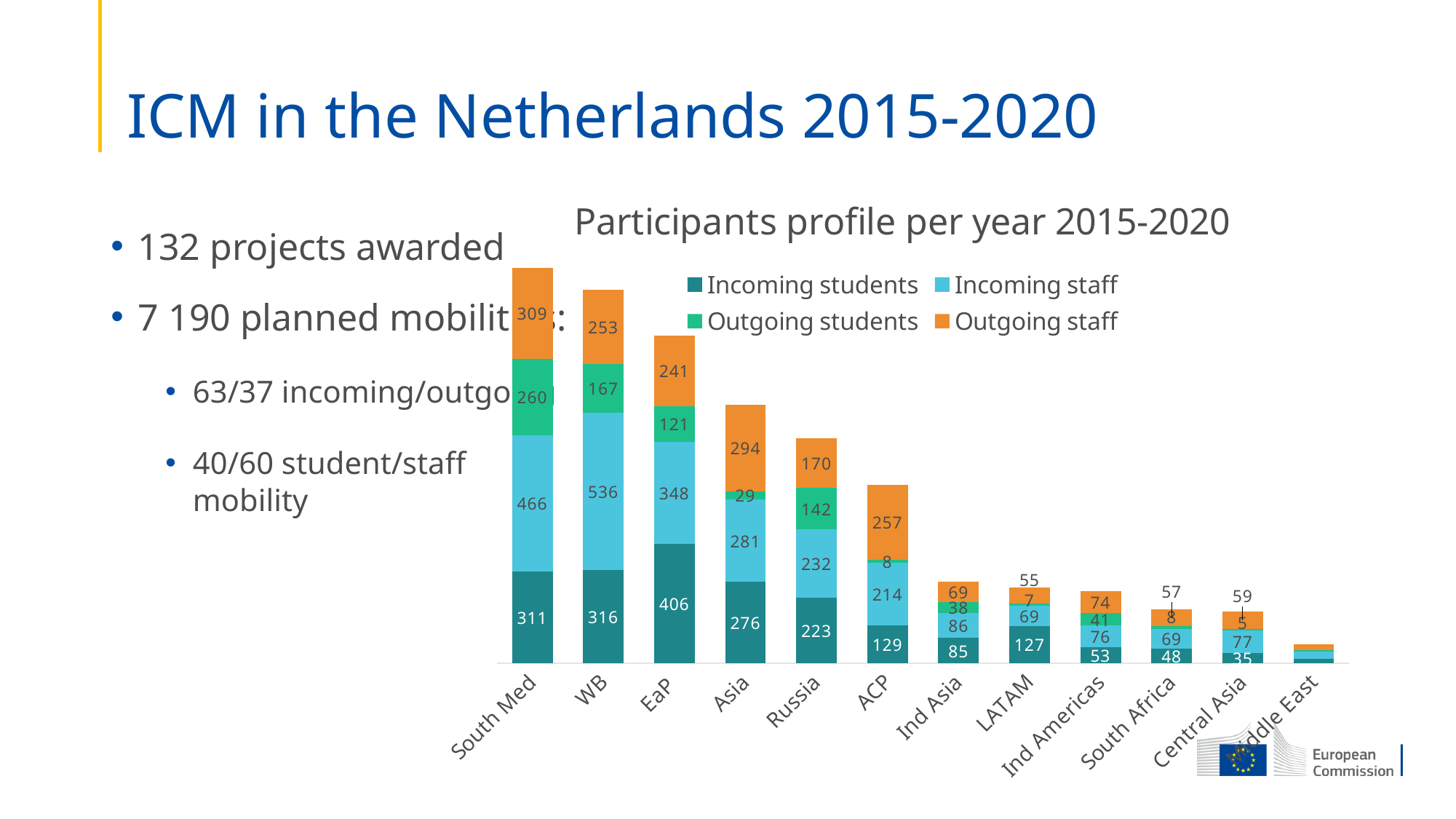
How many series does the legend list? 4 Which category has the highest Incoming students value? EaP Which category has the highest Incoming staff value? WB What is the value for Incoming students for EaP? 406 What is the value for Incoming staff in the WB bar? 536 What is the total of the stacked bar for South Med? 1346 Which is larger for Asia: Outgoing staff or Incoming staff? Outgoing staff How many categories are shown on the x axis? 12 What is the value for Outgoing students in the Russia bar? 142 What is the difference between the Incoming staff values for WB and South Med? 70 What is the value for Outgoing staff for ACP? 257 Which category has the lowest total stacked bar? Middle East